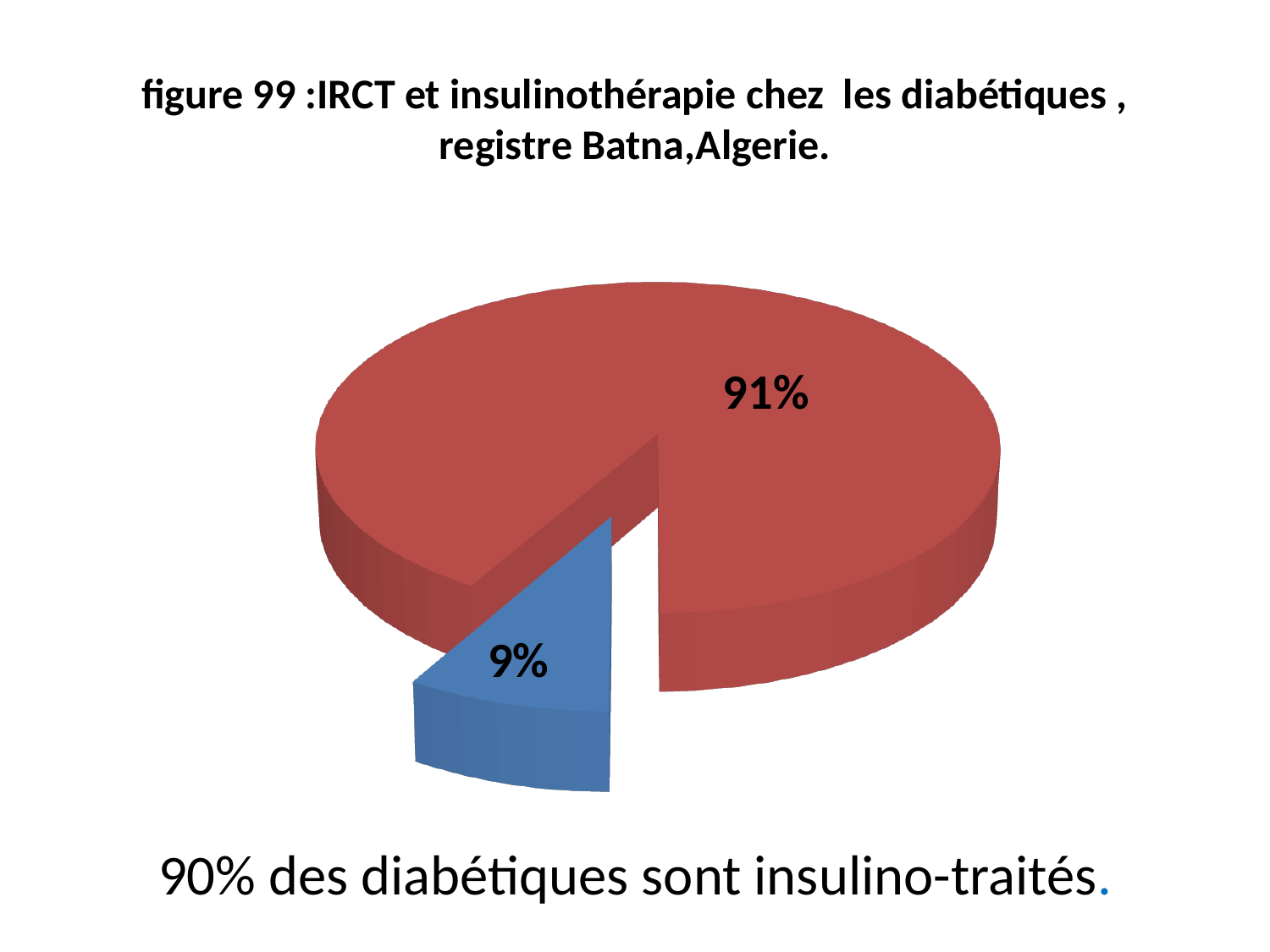
What share of the pie does the blue slice represent? 9% What percentage is shown on the red slice of the pie chart? 91% What kind of chart is shown on the slide? pie chart Which slice of the pie chart is the largest? the red slice (91%) Which slice of the pie chart is the smallest? the blue slice (9%) Which is larger, the red slice or the blue slice of the pie chart? the red slice What percentage is shown on the blue slice of the pie chart? 9% How many slices does the pie chart have? 2 What is the difference in percentage points between the red slice and the blue slice? 82 What is the figure number given in the chart title? figure 99 Is the value of the red slice greater or less than 50%? greater Which registry is named in the chart title? registre Batna, Algerie